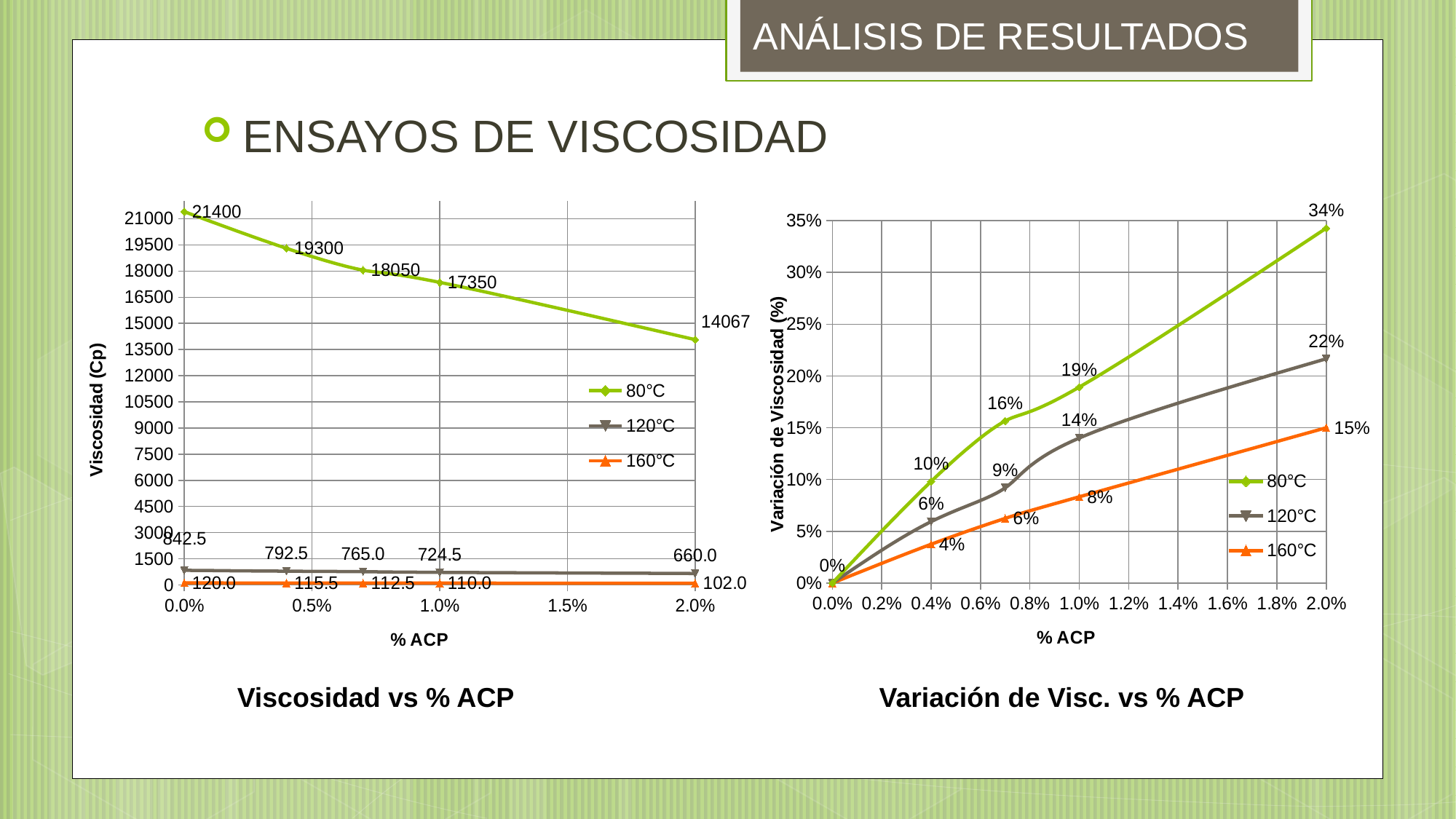
In the 'Variación de Visc. vs % ACP' chart, which series has the highest value at 2.0% ACP? 80°C In the 'Viscosidad vs % ACP' chart, does the 80°C series rise or fall as % ACP increases? fall In the 'Variación de Visc. vs % ACP' chart, what is the difference between the 80°C and 160°C values at 2.0% ACP? 19% In the 'Variación de Visc. vs % ACP' chart, what is the value for the 160°C series at 0.4% ACP? 4% What kind of chart is 'Variación de Visc. vs % ACP'? line chart In the 'Variación de Visc. vs % ACP' chart, what is the value for the 120°C series at 1.0% ACP? 14% In the 'Viscosidad vs % ACP' chart, what is the difference between the 80°C viscosity at 0.0% ACP and at 2.0% ACP? 7333 In the 'Viscosidad vs % ACP' chart, what is the viscosity for the 160°C series at 1.0% ACP? 110.0 In the 'Variación de Visc. vs % ACP' chart, what is the value for the 80°C series at 2.0% ACP? 34% How many series does the legend of the 'Viscosidad vs % ACP' chart list? 3 In the 'Viscosidad vs % ACP' chart, what is the viscosity for the 120°C series at 2.0% ACP? 660.0 In the 'Viscosidad vs % ACP' chart, what is the viscosity for the 80°C series at 0.0% ACP? 21400